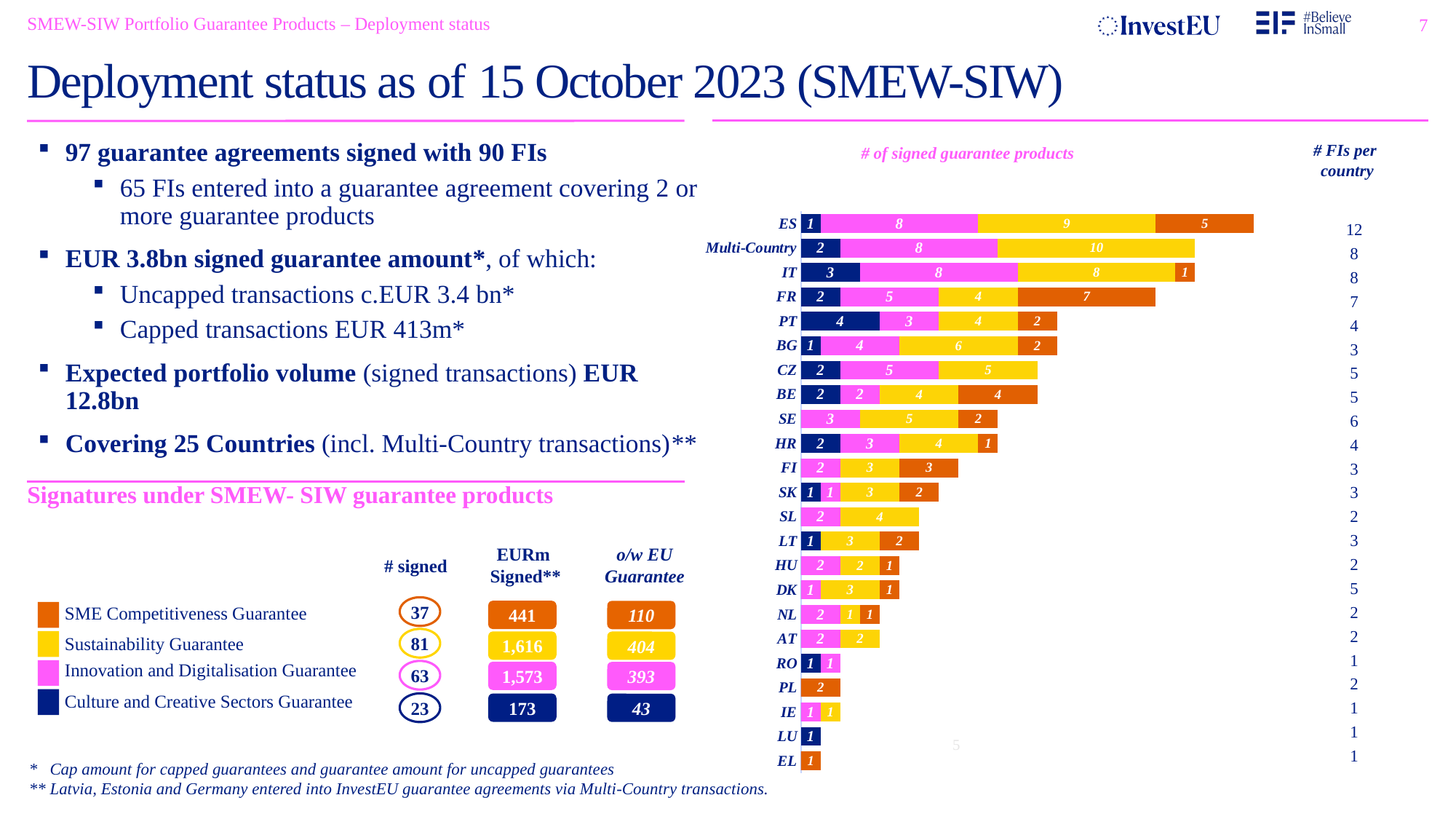
In the # of signed guarantee products chart, what is the value of the dark blue (Culture and Creative Sectors Guarantee) segment for PT? 4 What is the title of the stacked bar chart on the right of the slide? # of signed guarantee products In the # of signed guarantee products chart, which has a larger yellow (Sustainability Guarantee) segment, BG or CZ? BG In the # of signed guarantee products chart, which country has the highest total number of signed guarantee products? ES In the # of signed guarantee products chart, what is the value of the yellow (Sustainability Guarantee) segment for Multi-Country? 10 What kind of chart is used to show the # of signed guarantee products by country? stacked bar chart In the # of signed guarantee products chart, what is the difference between the orange (SME Competitiveness Guarantee) segment for FR and the orange segment for ES? 2 In the # of signed guarantee products chart, what is the value of the magenta (Innovation and Digitalisation Guarantee) segment for IT? 8 In the # of signed guarantee products chart, what is the value of the orange (SME Competitiveness Guarantee) segment for FR? 7 In the # of signed guarantee products chart, what is the total number of signed guarantee products for PT? 13 In the # of signed guarantee products chart, how many countries/categories are shown? 23 In the # of signed guarantee products chart, what is the total number of signed guarantee products for ES? 23